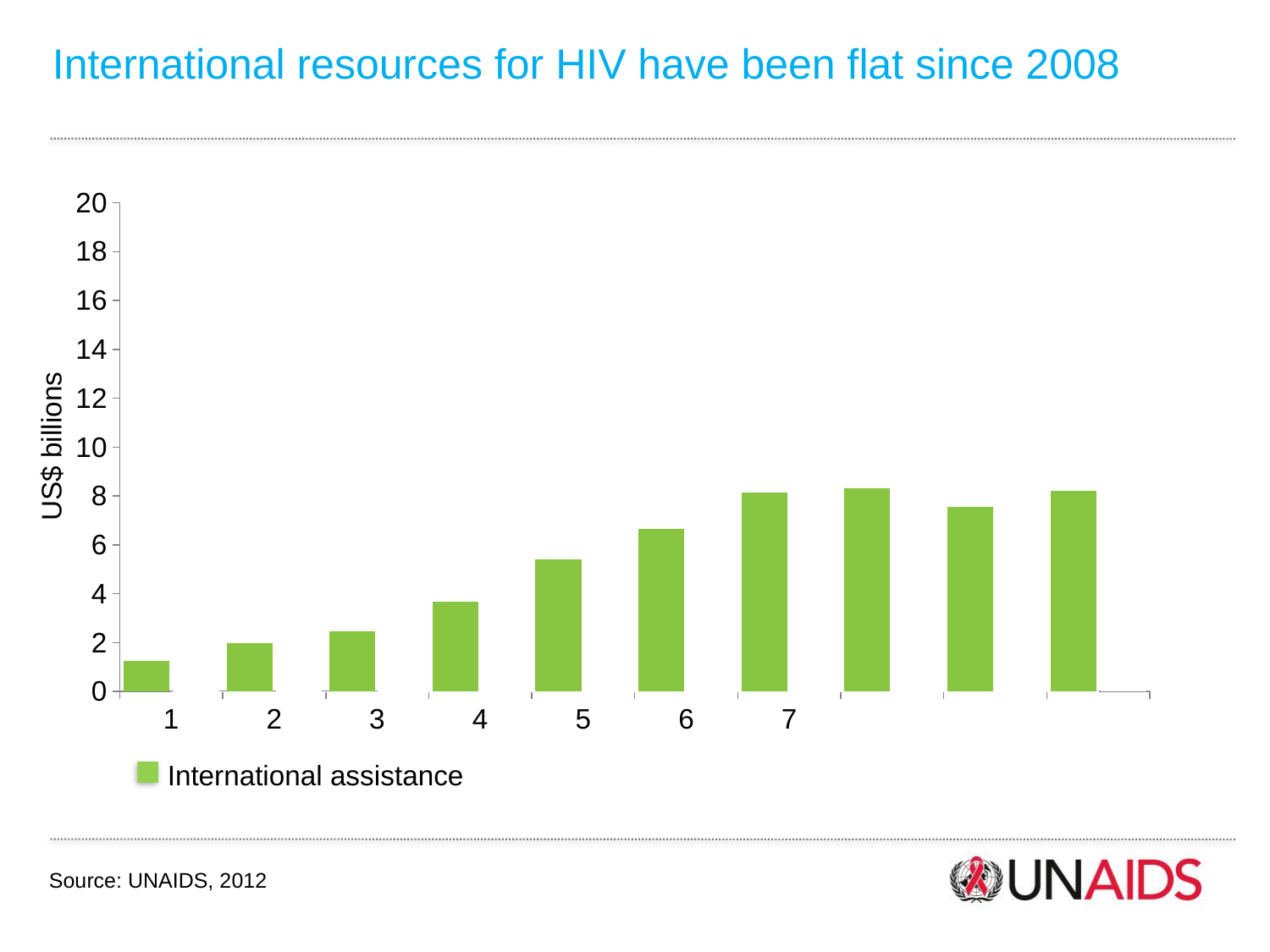
What is the name of the series shown in the legend? International assistance How many series does the legend list? 1 How many bars are plotted in the chart? 10 Is the value for category 5 greater or less than 4? greater What is the label on the vertical axis? US$ billions Do the values rise or fall from category 1 to category 7? rise Is the value for category 3 greater or less than 4? less What kind of chart is shown on the slide? bar chart Is the value for category 7 greater or less than 6? greater Which is larger, the value for category 6 or the value for category 4? 6 Which category has the lowest value? 1